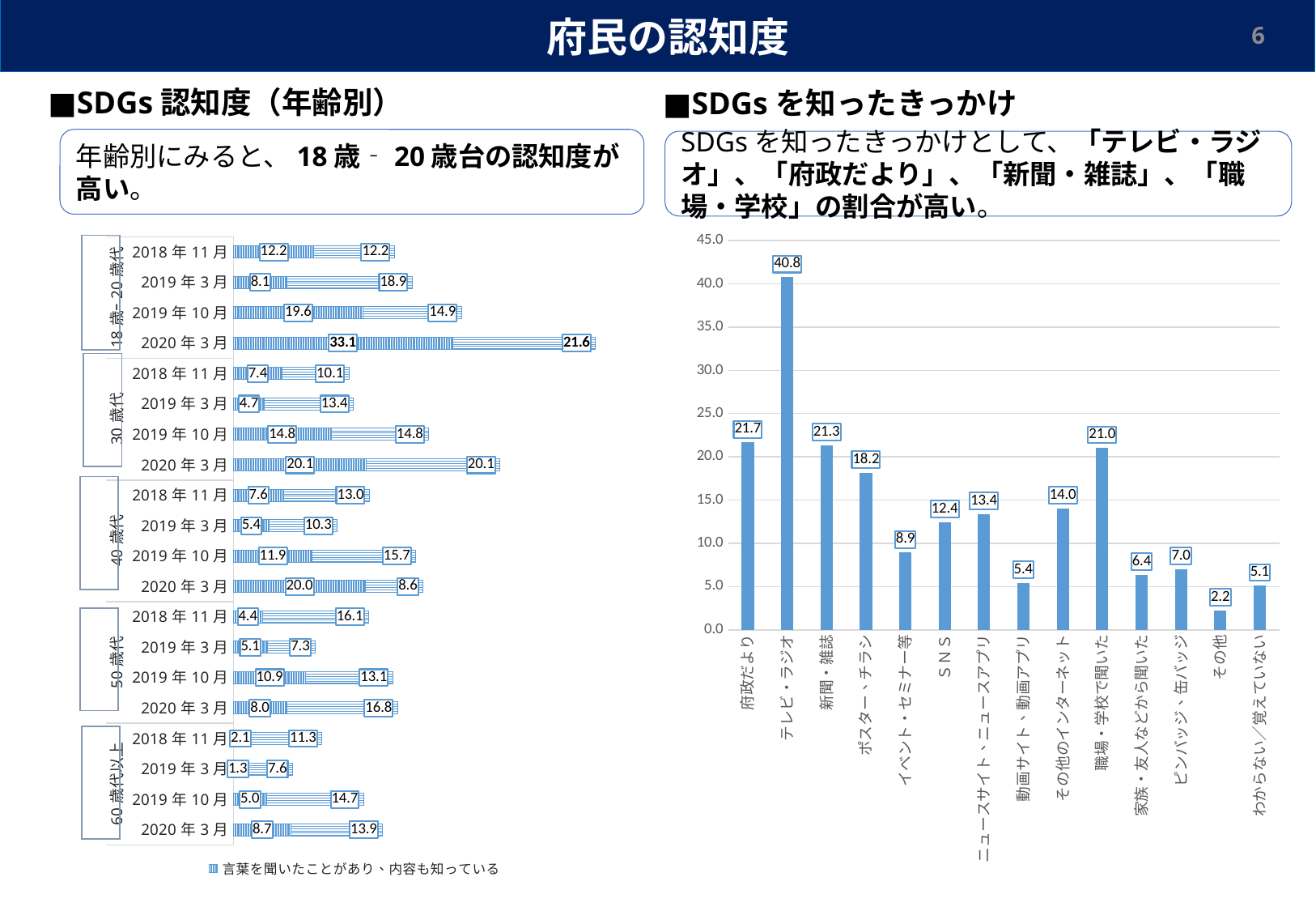
What is the legend entry shown below the left-hand chart (SDGs認知度（年齢別）)? 言葉を聞いたことがあり、内容も知っている In the right-hand chart (SDGsを知ったきっかけ), what is the value for 職場・学校で聞いた? 21.0 In the left-hand chart (SDGs認知度（年齢別）), what is the value of the first (left) segment for 18歳-20歳代 in 2020年3月? 33.1 In the right-hand chart (SDGsを知ったきっかけ), what is the difference between 府政だより and 新聞・雑誌? 0.4 What kind of chart is the right-hand chart (SDGsを知ったきっかけ)? bar chart In the right-hand chart (SDGsを知ったきっかけ), which category has the highest value? テレビ・ラジオ In the right-hand chart (SDGsを知ったきっかけ), which is larger: SNS or ニュースサイト・ニュースアプリ? ニュースサイト・ニュースアプリ In the left-hand chart (SDGs認知度（年齢別）), what is the value of the first (left) segment for 60歳代以上 in 2019年3月? 1.3 In the right-hand chart (SDGsを知ったきっかけ), which category has the lowest value? その他 How many categories are shown in the right-hand chart (SDGsを知ったきっかけ)? 14 In the right-hand chart (SDGsを知ったきっかけ), is the value for ポスター・チラシ greater or less than 20.0? less In the left-hand chart (SDGs認知度（年齢別）), what is the total of the two segments for 18歳-20歳代 in 2020年3月? 54.7